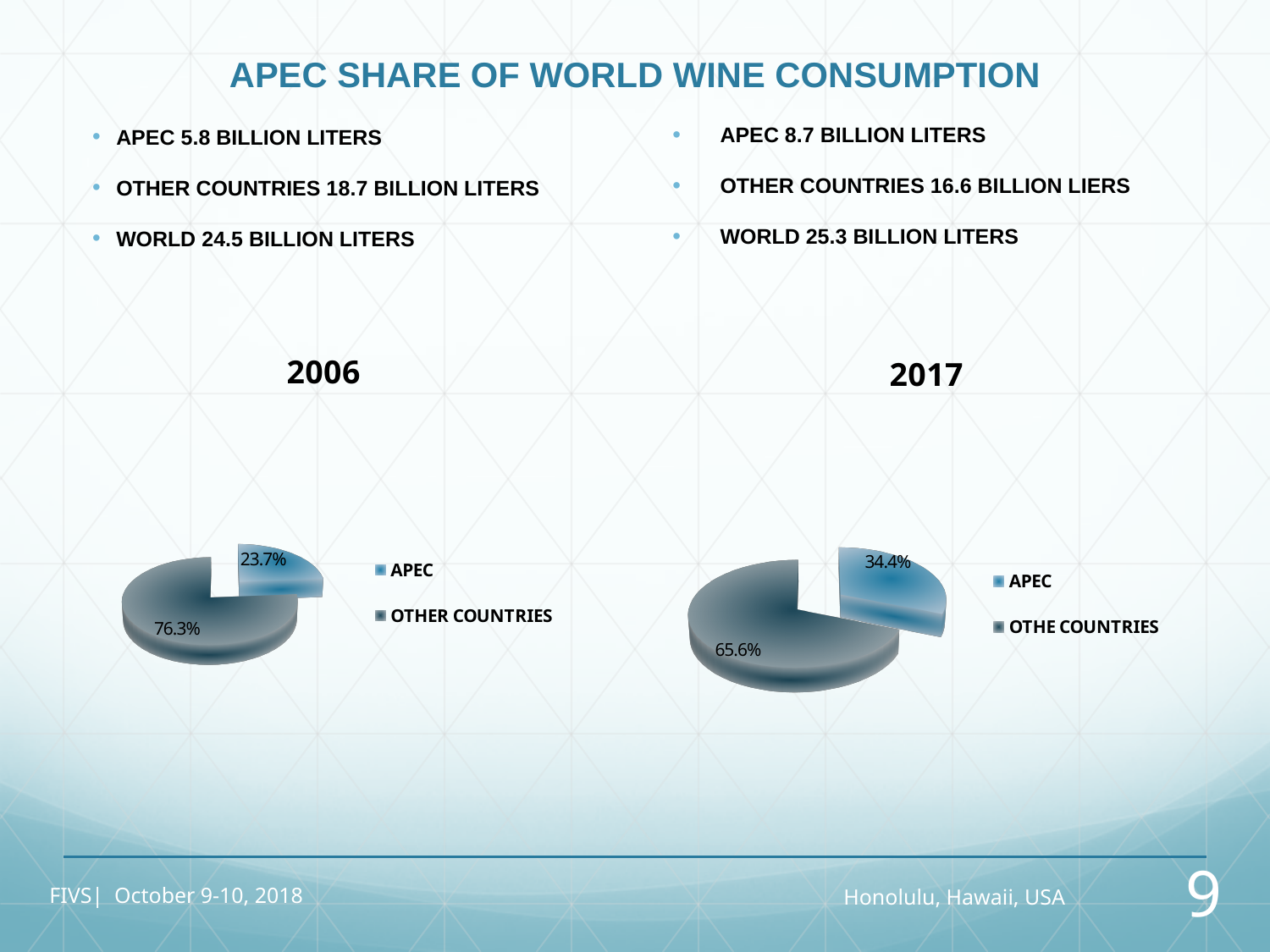
In the 2017 pie chart, which slice is the smallest? APEC In the 2006 pie chart, what is the difference between the Other Countries share and the APEC share? 52.6% How many slices does the 2017 pie chart have? 2 In the 2017 pie chart, what share does APEC have? 34.4% In the 2017 pie chart, what share do Other Countries have? 65.6% Is the APEC share larger in the 2006 pie chart or the 2017 pie chart? 2017 In the 2006 pie chart, what share do Other Countries have? 76.3% How many entries does the legend of the 2006 pie chart list? 2 In the 2006 pie chart, which slice is the largest? OTHER COUNTRIES What kind of chart is the 2006 chart? Pie chart In the 2017 pie chart, what is the difference between the Other Countries share and the APEC share? 31.2%